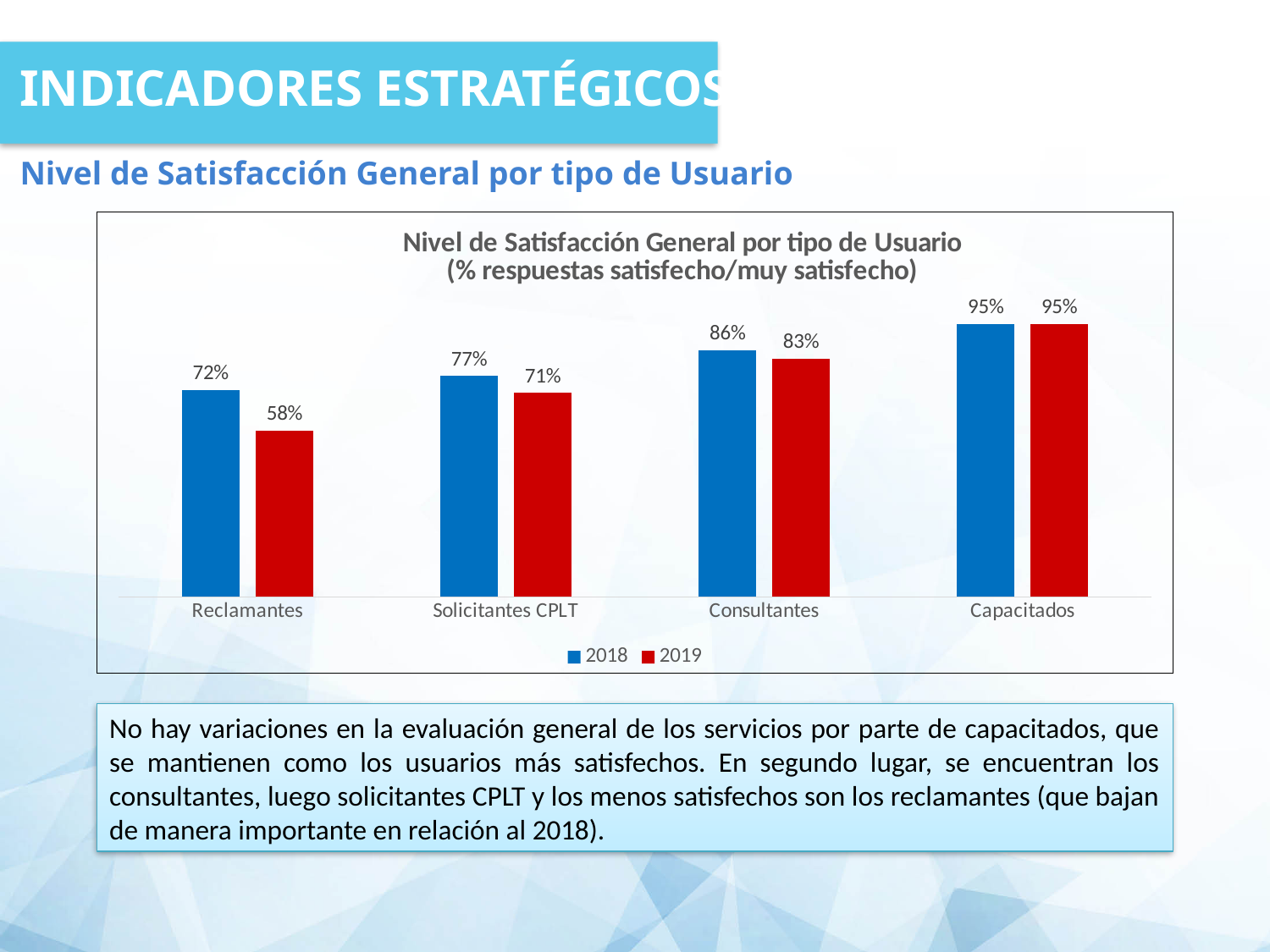
Which colour represents the 2019 series? Red Which is larger for Consultantes, the 2018 value or the 2019 value? 2018 What is the 2019 value for Reclamantes? 58% What is the 2018 value for Consultantes? 86% How many series does the legend list? 2 Which category has the highest 2018 value? Capacitados Which category has the lowest 2019 value? Reclamantes What kind of chart is shown? Bar chart What is the 2019 value for Solicitantes CPLT? 71% Do the 2019 values rise or fall from Reclamantes to Capacitados? Rise How many categories are shown on the x axis? 4 What is the difference between the 2018 and 2019 values for Reclamantes? 14 percentage points